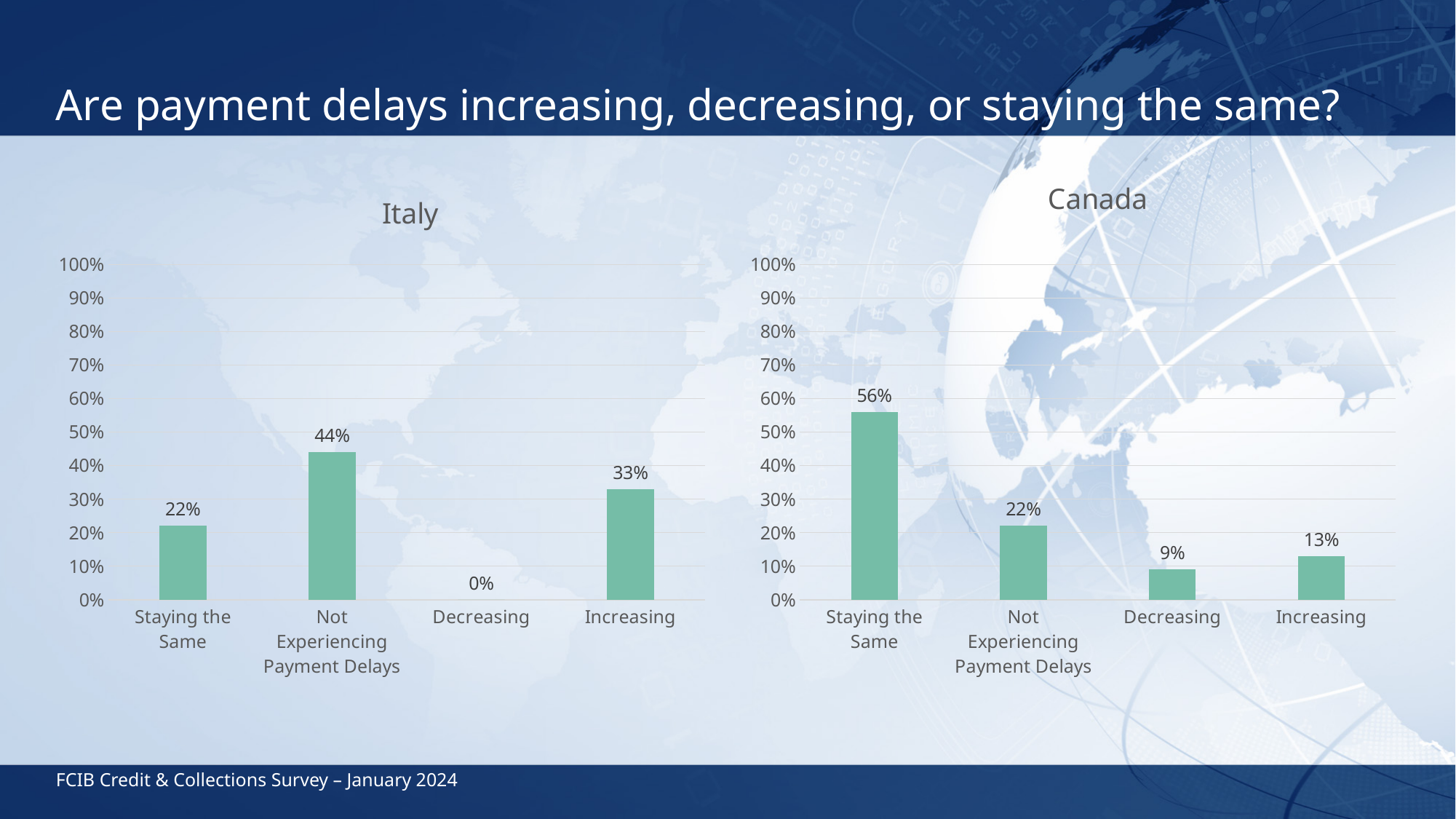
In the Italy chart, what is the difference between Not Experiencing Payment Delays and Increasing? 11% In the Canada chart, is the value for Staying the Same greater or less than 50%? greater In the Canada chart, which category has the lowest value? Decreasing In the Italy chart, which category has the highest value? Not Experiencing Payment Delays What type of chart is the Canada chart? Bar chart In the Italy chart, what is the value for Decreasing? 0% In the Canada chart, what is the value for Decreasing? 9% Which is larger: the Increasing value in the Italy chart or the Increasing value in the Canada chart? Italy In the Italy chart, what is the value for Not Experiencing Payment Delays? 44% How many categories are shown in the Italy chart? 4 In the Canada chart, what is the value for Staying the Same? 56% In the Canada chart, what is the difference between Staying the Same and Not Experiencing Payment Delays? 34%